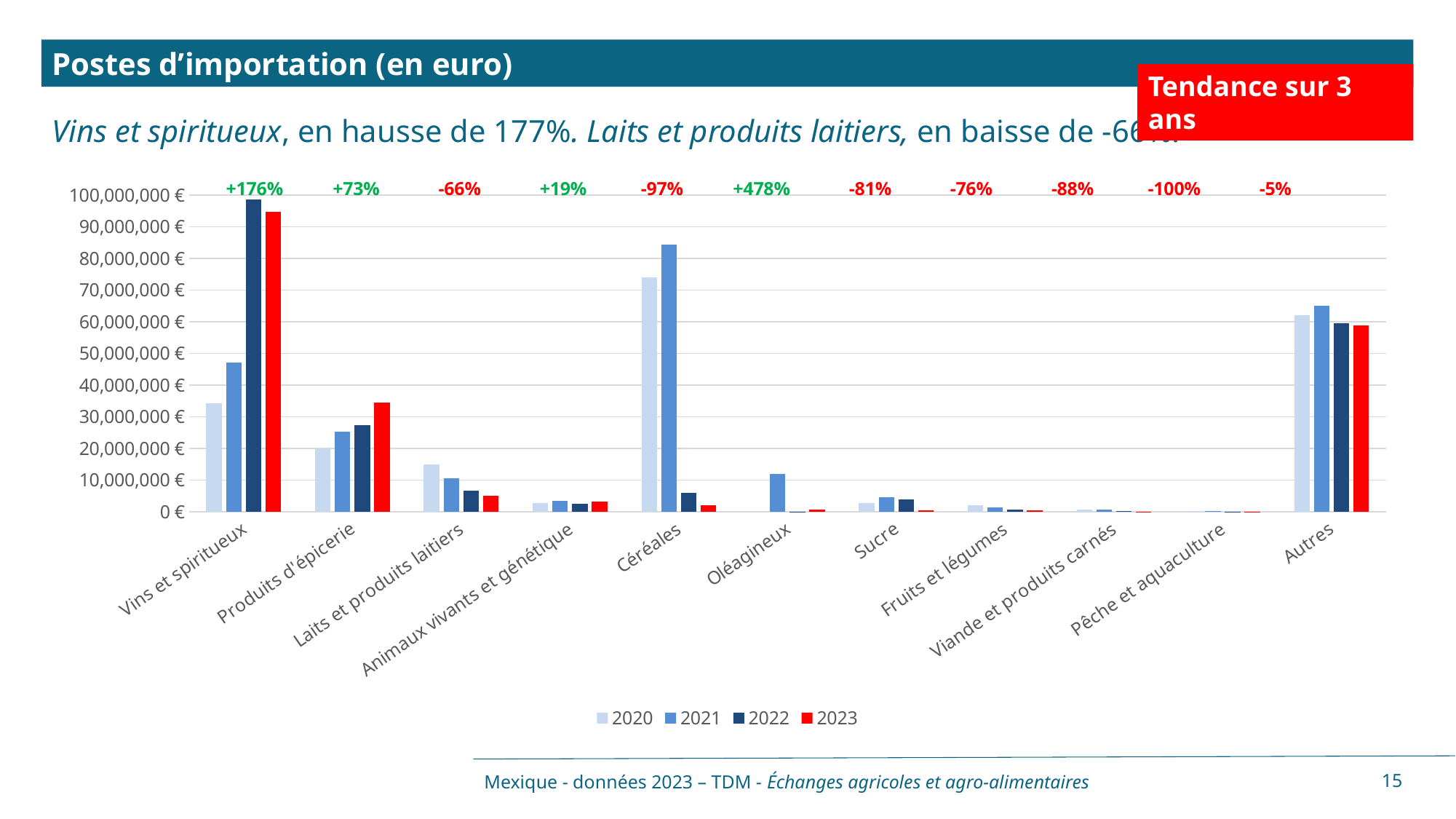
Is the 2022 value for Vins et spiritueux greater or less than 90,000,000 €? greater What 3-year trend percentage is printed above Oléagineux? +478% How many categories are shown on the x axis? 11 Which category has the highest 2023 value? Vins et spiritueux Do the values for Laits et produits laitiers rise or fall from 2020 to 2023? fall How many series does the legend list? 4 What kind of chart is shown on the slide? bar chart Which is larger for Produits d'épicerie, the 2020 value or the 2023 value? 2023 What 3-year trend percentage is printed above Pêche et aquaculture? -100% What 3-year trend percentage is printed above Vins et spiritueux? +176% What 3-year trend percentage is printed above Céréales? -97% Is the 2021 value for Céréales greater or less than 80,000,000 €? greater